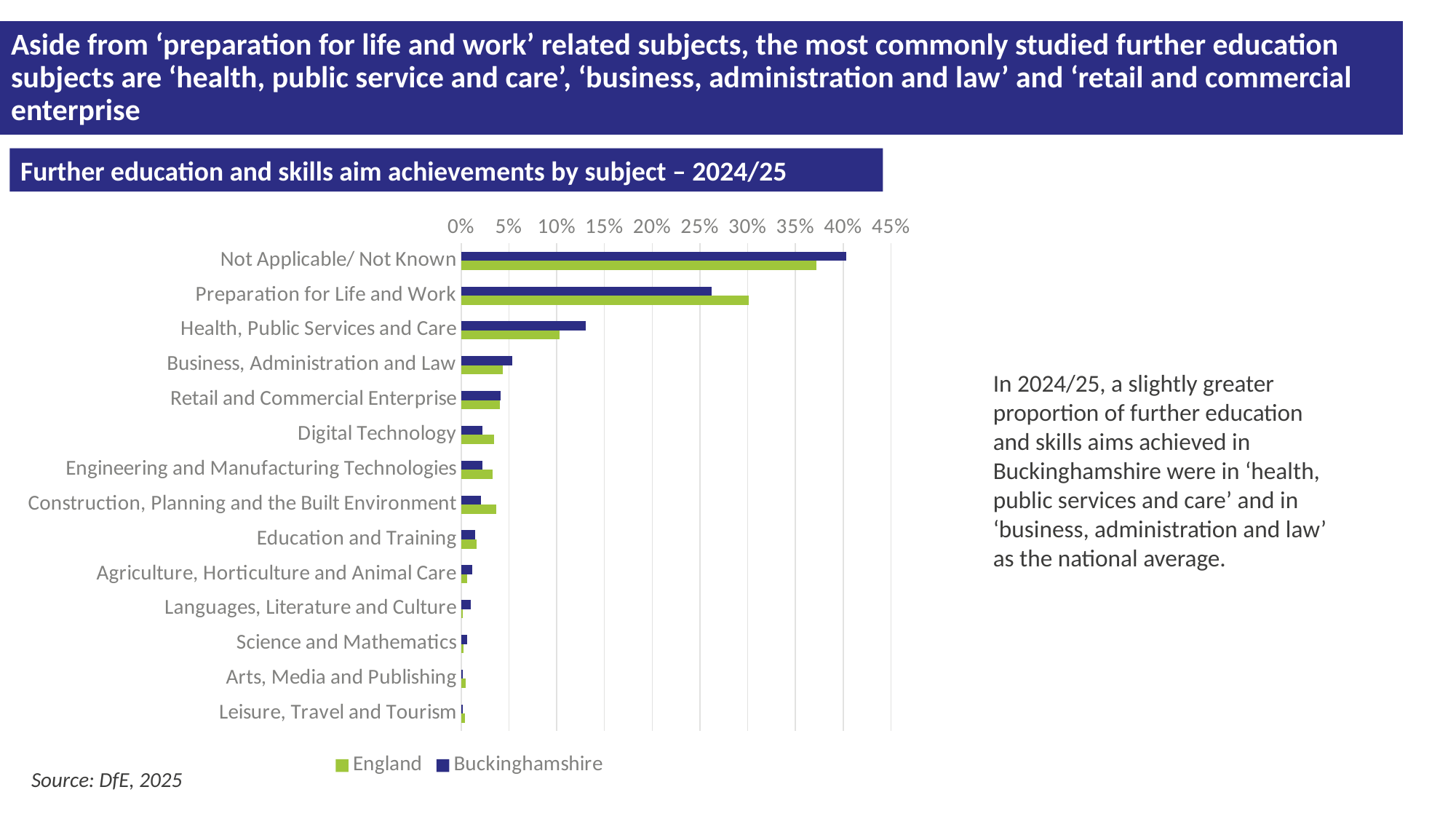
Is the England value for Business, Administration and Law greater or less than 10%? less Is the England value for Preparation for Life and Work greater or less than 25%? greater Is the Buckinghamshire value for Not Applicable/ Not Known greater or less than 35%? greater What kind of chart is shown on the slide? bar chart How many subject categories are plotted on the chart? 14 Which subject category has the highest value for Buckinghamshire? Not Applicable/ Not Known How many series does the legend list? 2 For Health, Public Services and Care, which is larger: the England value or the Buckinghamshire value? Buckinghamshire Which subject category has the highest value for England? Not Applicable/ Not Known For Preparation for Life and Work, which is larger: the England value or the Buckinghamshire value? England What is the title of the chart? Further education and skills aim achievements by subject – 2024/25